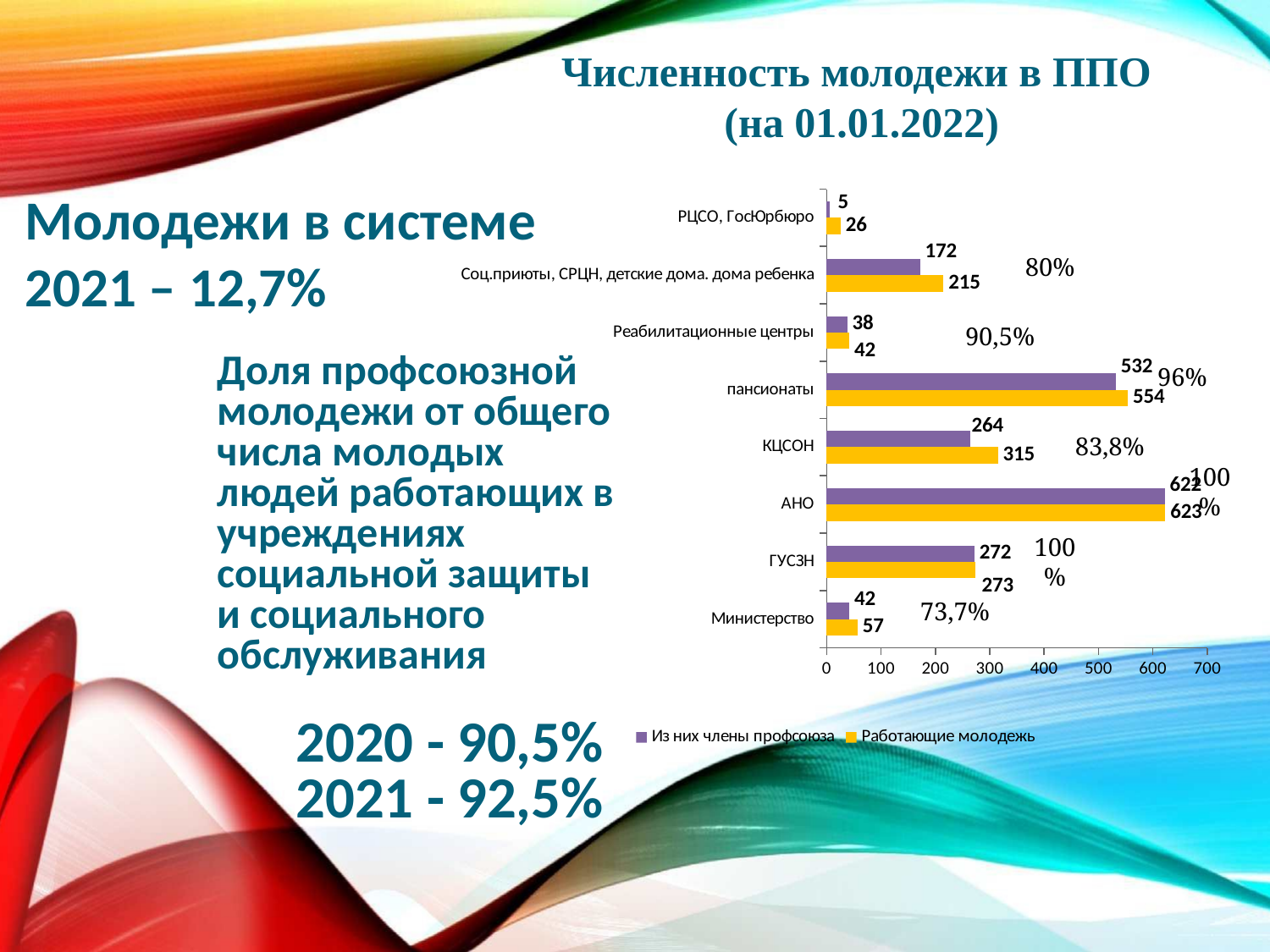
How many categories are shown on the chart? 8 Which is larger: 'Работающие молодежь' for пансионаты or for ГУСЗН? пансионаты What kind of chart is shown on the slide? bar chart Which category has the lowest value for 'Из них члены профсоюза'? РЦСО, ГосЮрбюро Which series is shown in yellow in the chart legend? Работающие молодежь How many series does the chart legend list? 2 What is the value of 'Из них члены профсоюза' for КЦСОН? 264 What is the value of 'Работающие молодежь' for Министерство? 57 What is the value of 'Из них члены профсоюза' for РЦСО, ГосЮрбюро? 5 What is the value of 'Работающие молодежь' for пансионаты? 554 What is the difference between 'Работающие молодежь' and 'Из них члены профсоюза' for КЦСОН? 51 Which category has the highest value for 'Работающие молодежь'? АНО